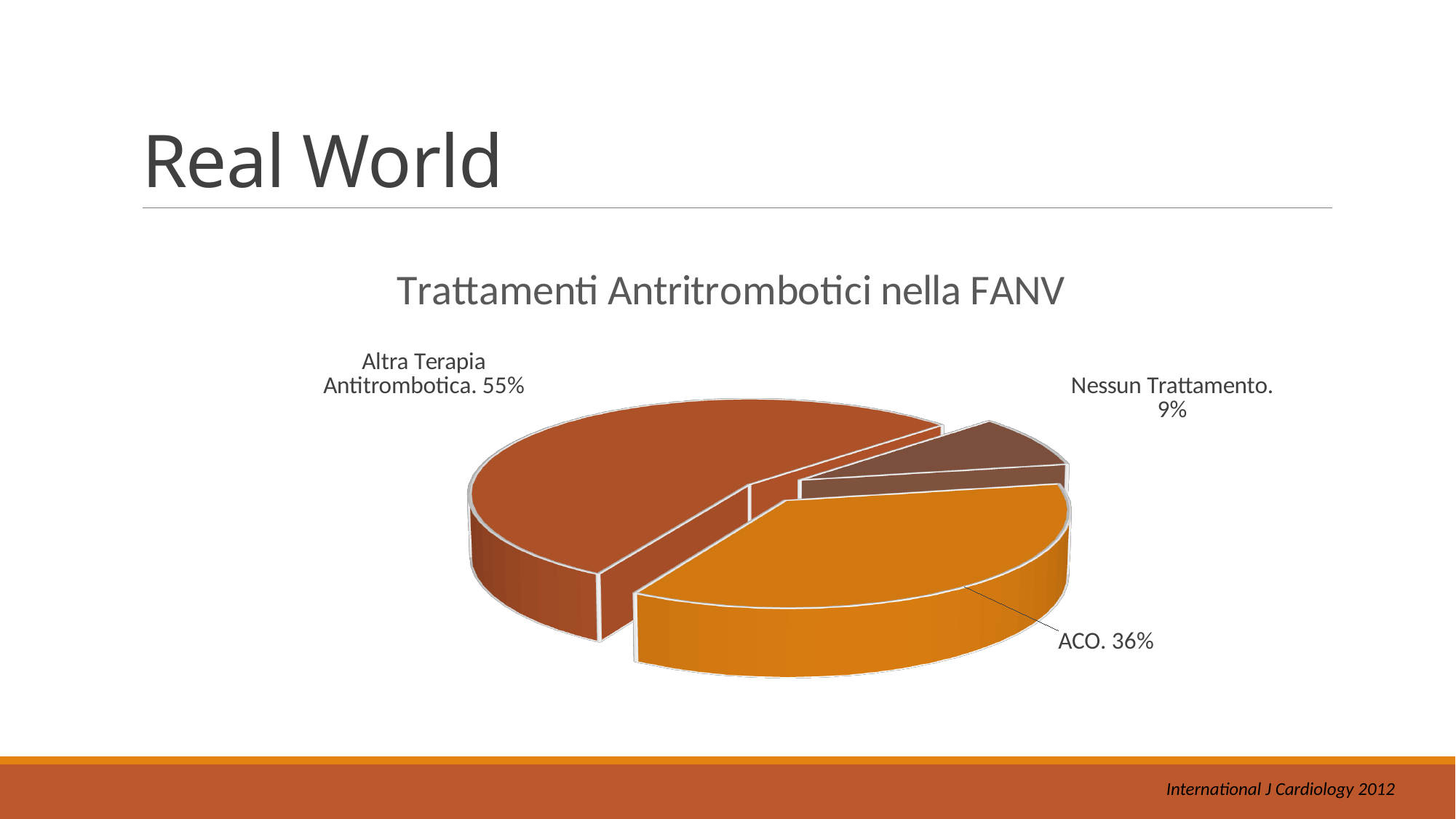
Which category has the smallest slice of the pie? Nessun Trattamento Which category has the largest slice of the pie? Altra Terapia Antitrombotica What is the difference in percentage points between Altra Terapia Antitrombotica and ACO? 19% What kind of chart is shown on the slide? Pie chart What share of the pie does Nessun Trattamento represent? 9% What is the title of the chart? Trattamenti Antritrombotici nella FANV Is the share for Altra Terapia Antitrombotica greater or less than 50%? greater How many slices does the pie chart have? 3 What share of the pie does Altra Terapia Antitrombotica represent? 55% What share of the pie does ACO represent? 36% Which is larger, the share for ACO or the share for Nessun Trattamento? ACO What is the difference in percentage points between ACO and Nessun Trattamento? 27%